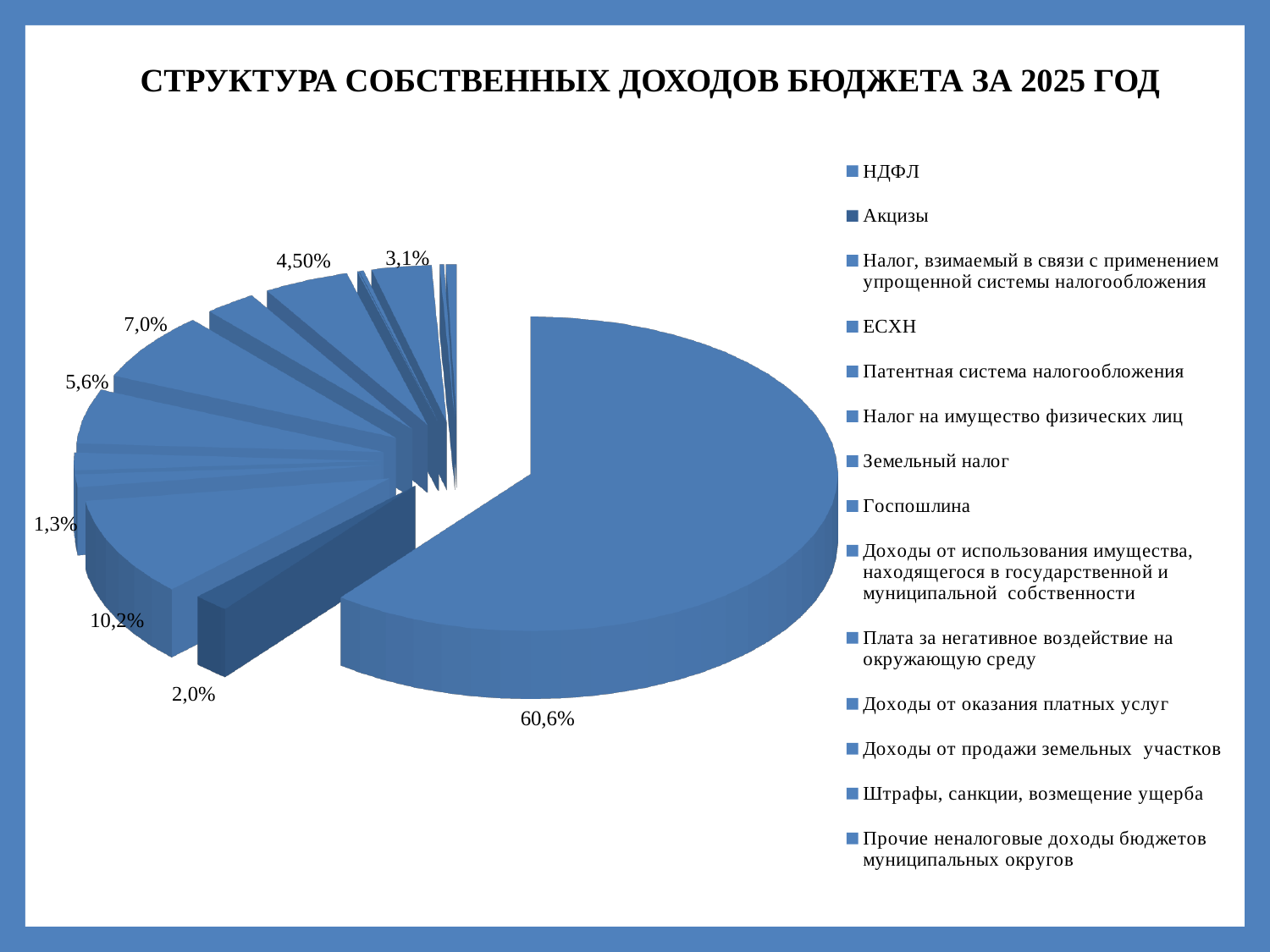
What is the difference between the 10,2% slice and the 7,0% slice? 3,2% What is the difference between the largest slice (60,6%) and the 10,2% slice? 50,4% What is the first entry listed in the legend? НДФЛ What kind of chart is shown on the slide? pie chart Is the largest slice of the pie greater or less than 50%? greater What is the title of the chart? СТРУКТУРА СОБСТВЕННЫХ ДОХОДОВ БЮДЖЕТА ЗА 2025 ГОД How many entries does the legend list? 14 What is the value of the largest slice of the pie? 60,6% What is the smallest value printed as a data label on the pie? 1,3% Which is larger, the slice labelled 2,0% or the slice labelled 3,1%? 3,1% How many slices have a percentage data label printed on the chart? 8 Which is larger, the slice labelled 5,6% or the slice labelled 4,50%? 5,6%